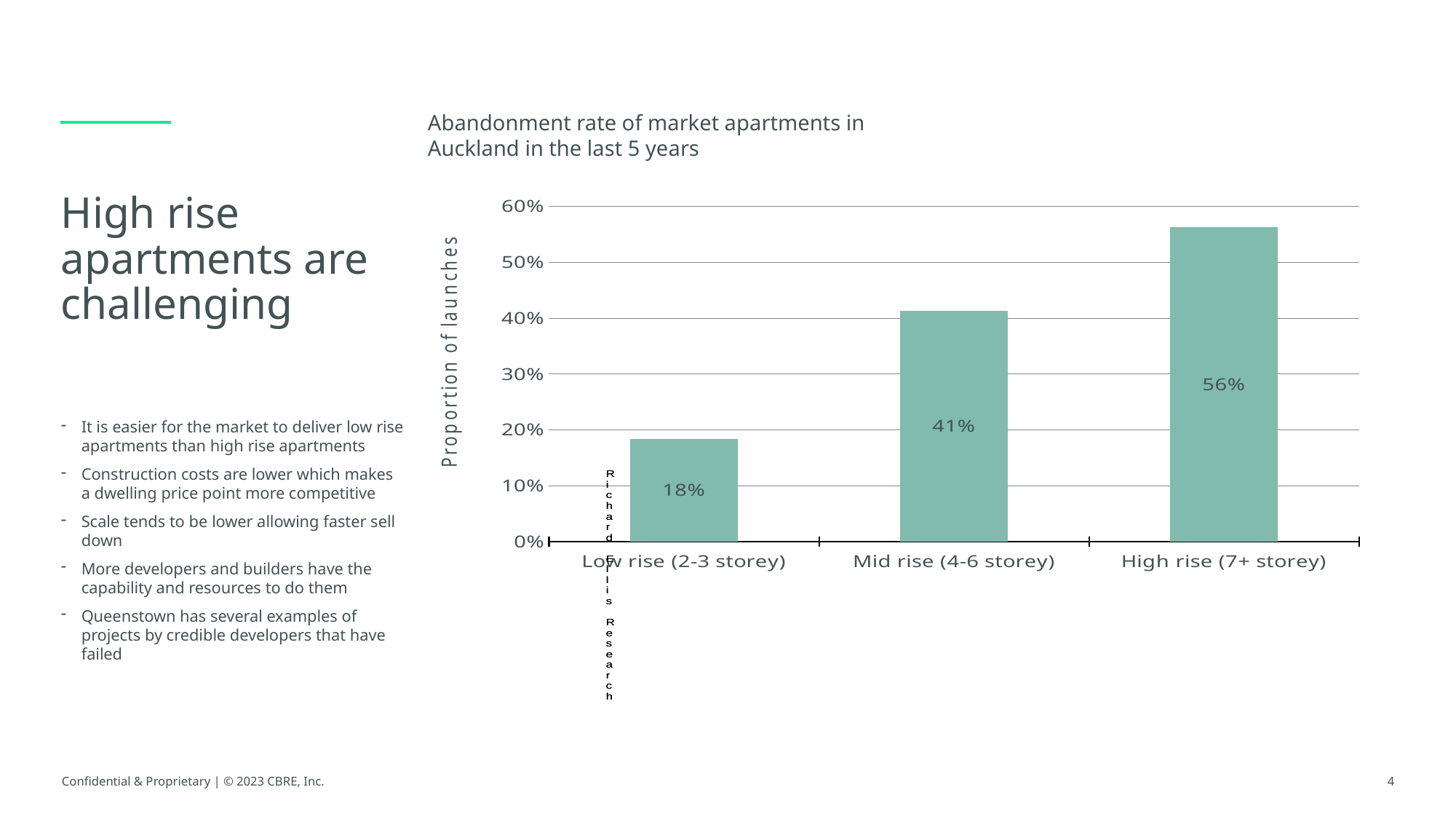
What kind of chart is shown on the slide? Bar chart What is the abandonment rate for Mid rise (4-6 storey) apartments? 41% What is the title of the chart? Abandonment rate of market apartments in Auckland in the last 5 years What is the abandonment rate for High rise (7+ storey) apartments? 56% Is the abandonment rate for Mid rise (4-6 storey) greater or less than 30%? greater How many categories are shown in the chart? 3 Which category has the highest abandonment rate? High rise (7+ storey) What is the abandonment rate for Low rise (2-3 storey) apartments? 18% Which category has the lowest abandonment rate? Low rise (2-3 storey) Which has a higher abandonment rate, Mid rise (4-6 storey) or High rise (7+ storey)? High rise (7+ storey) What is the difference in abandonment rate between Mid rise (4-6 storey) and Low rise (2-3 storey)? 23% What is the difference in abandonment rate between High rise (7+ storey) and Low rise (2-3 storey)? 38%